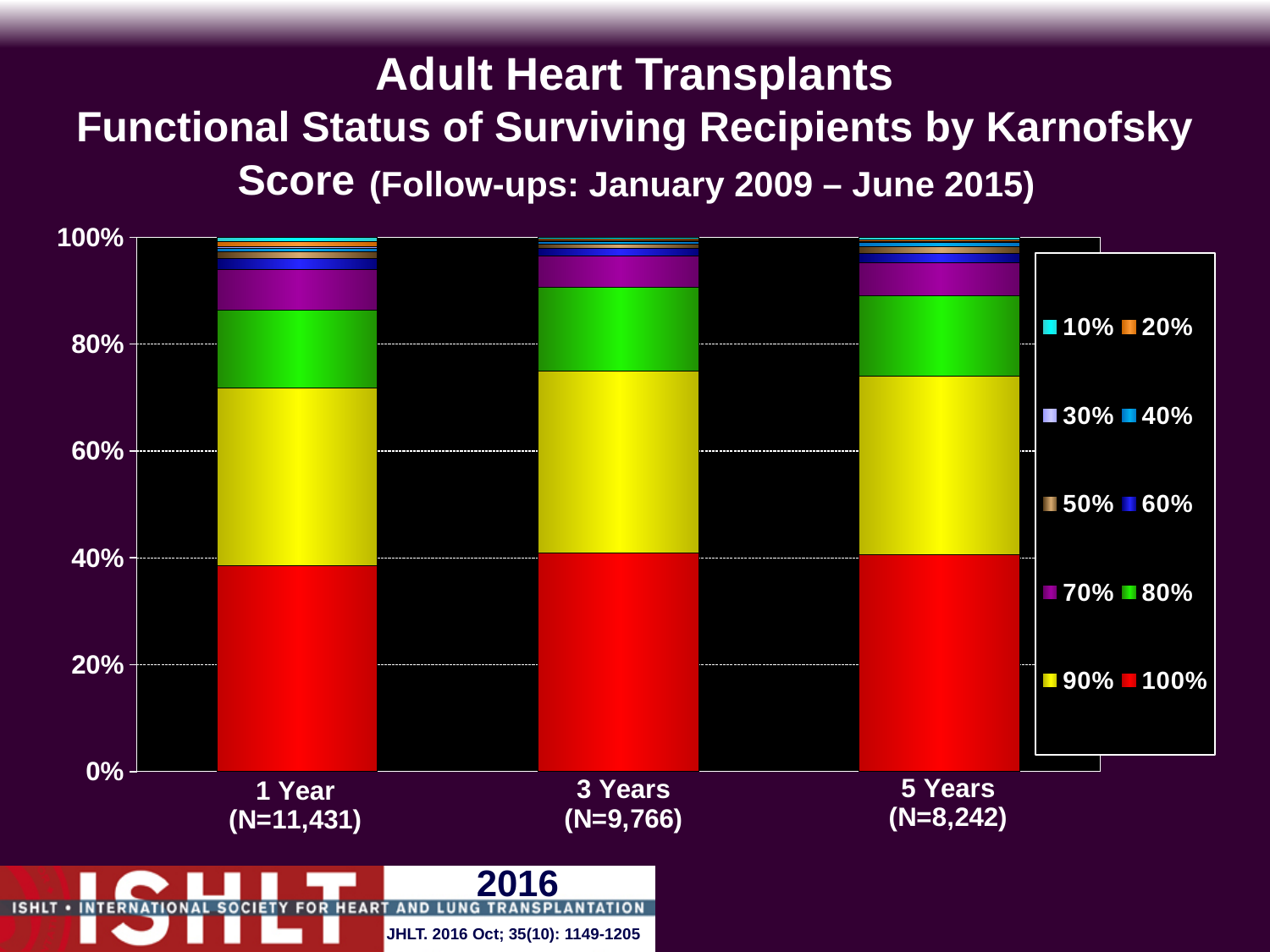
Is the combined share of recipients with Karnofsky scores of 80%, 90% and 100% at 3 Years greater or less than 80%? greater What is the number of recipients (N) for the 1 Year follow-up? N=11,431 Which colour represents the 100% Karnofsky score in the legend? red What kind of chart is shown on the slide? stacked bar chart Is the share of recipients with a Karnofsky score of 100% at 1 Year greater or less than 20%? greater How many follow-up time points (categories) are shown on the x axis? 3 Is the share of recipients with a Karnofsky score of 100% at 5 Years greater or less than 60%? less How many Karnofsky score series does the legend list? 10